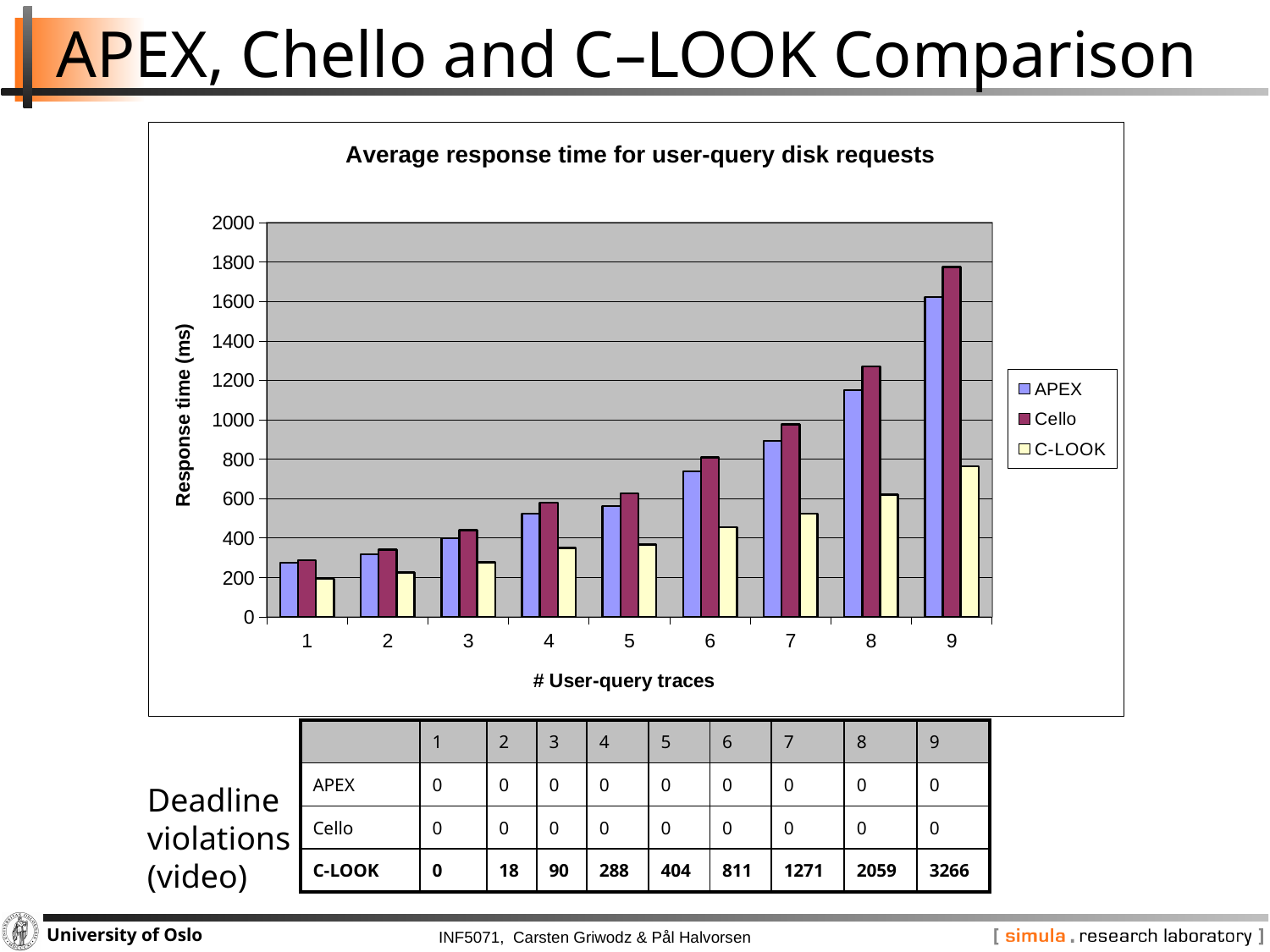
Which series has the highest response time for user-query trace 9? Cello Which series has the lowest response time for user-query trace 5? C-LOOK Which is larger for trace 8: the APEX response time or the C-LOOK response time? APEX How many user-query trace categories are shown on the x axis? 9 What is the label of the chart's y axis? Response time (ms) Do the response times for APEX rise or fall as the number of user-query traces increases? rise For which user-query trace is the Cello response time highest? 9 What kind of chart is shown on the slide? bar chart Is the Cello response time for trace 9 greater or less than 1600? greater How many series does the chart legend list? 3 Is the C-LOOK response time for trace 9 greater or less than 1000? less Is the APEX response time for trace 8 greater or less than 1000? greater